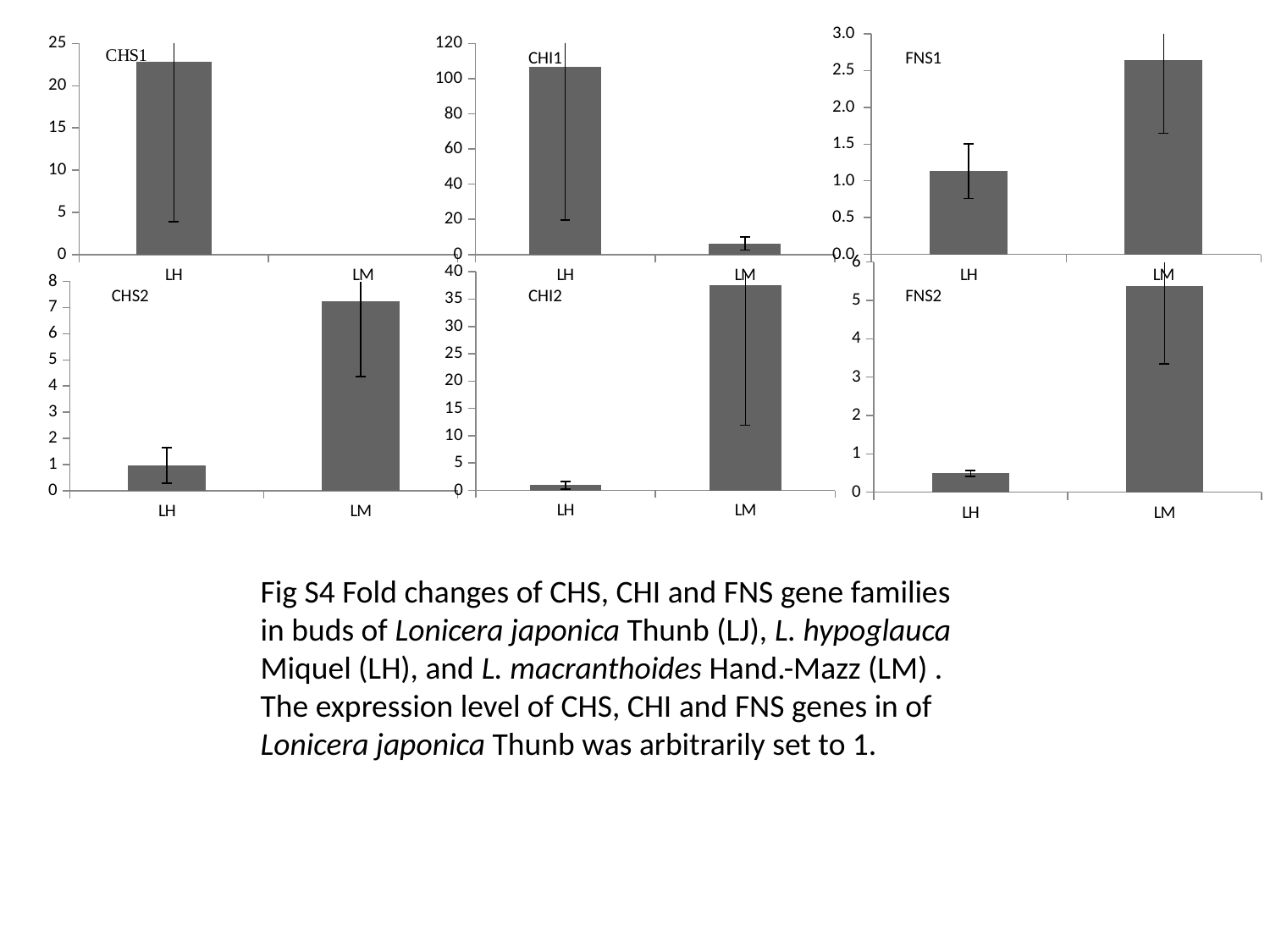
In the FNS1 chart, is the value for LM greater or less than 2.5? greater In the CHS2 chart, which category has the highest value? LM In the FNS2 chart, is the value for LH greater or less than 1? less In the CHI1 chart, is the value for LH greater or less than 100? greater What kind of chart is the CHS1 chart? bar chart How many categories are shown on the x axis of the CHI1 chart? 2 In the FNS1 chart, which category has the lowest value? LH In the CHI1 chart, which category has the higher value, LH or LM? LH